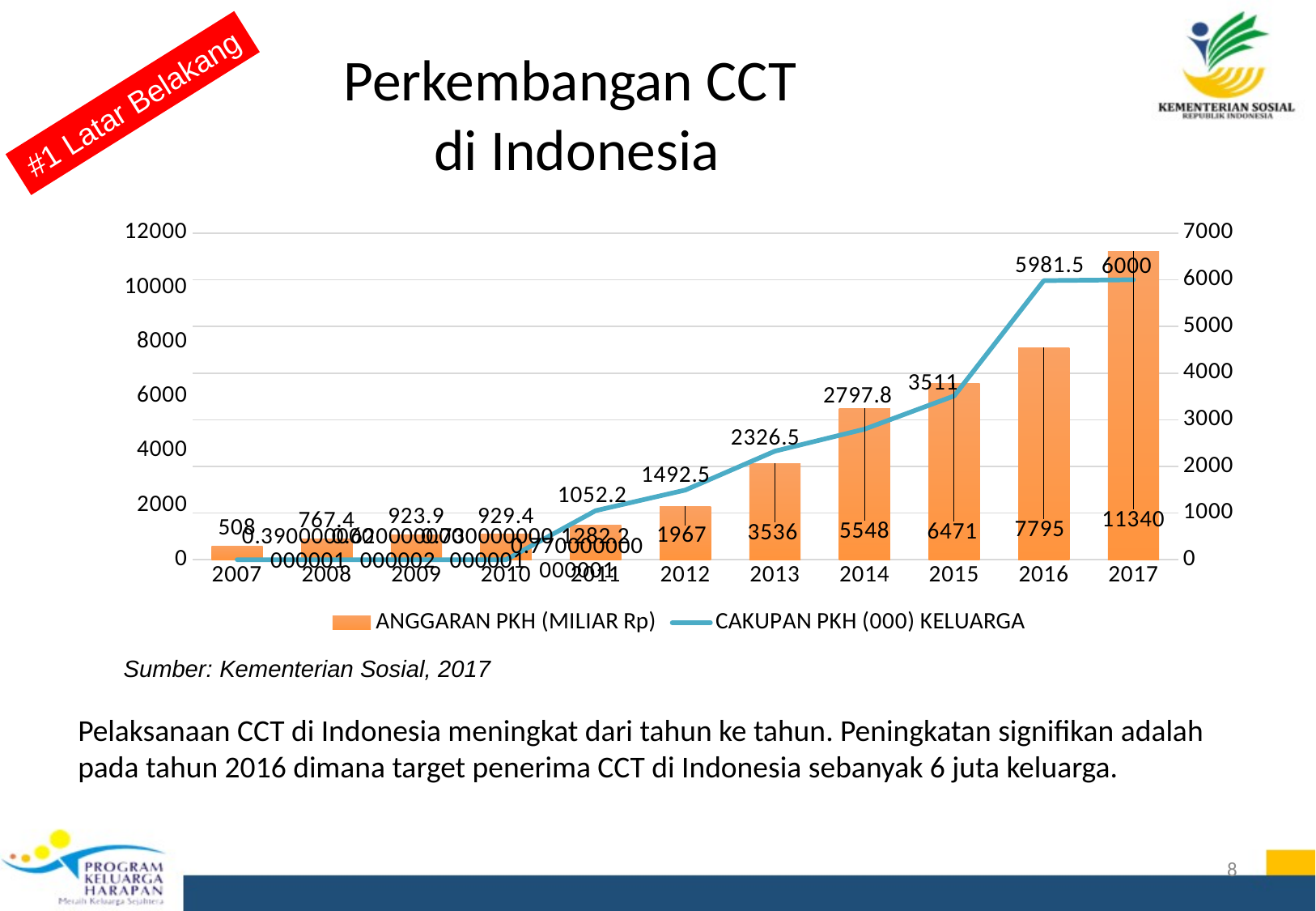
What is the difference in ANGGARAN PKH (MILIAR Rp) between 2017 and 2016? 3545 What is the CAKUPAN PKH (000) KELUARGA value for 2013? 2326.5 What is the ANGGARAN PKH (MILIAR Rp) value for 2017? 11340 What is the ANGGARAN PKH (MILIAR Rp) value for 2015? 6471 How many series does the legend list? 2 Which year has the highest ANGGARAN PKH (MILIAR Rp)? 2017 How many years are shown on the x axis? 11 What is the CAKUPAN PKH (000) KELUARGA value for 2016? 5981.5 Does the ANGGARAN PKH (MILIAR Rp) rise or fall from 2007 to 2017? Rise Which year has the lowest ANGGARAN PKH (MILIAR Rp)? 2007 What kind of chart is shown on the slide? A combined bar and line chart Which year has the larger ANGGARAN PKH (MILIAR Rp), 2013 or 2014? 2014